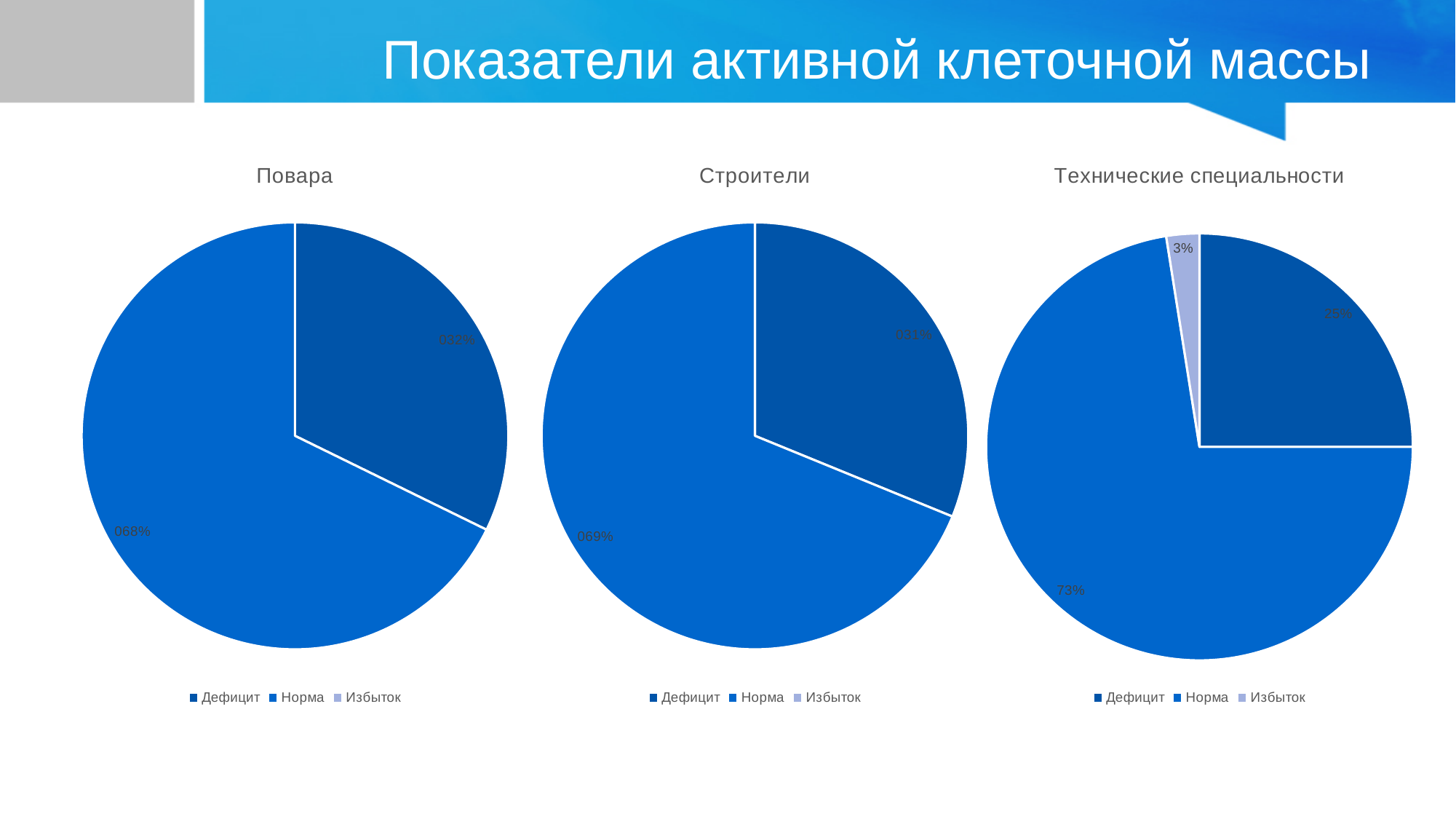
In the 'Повара' chart, what is the value for Норма? 068% In the 'Строители' chart, which category has the largest slice? Норма What kind of chart is the 'Повара' chart? pie chart In the 'Технические специальности' chart, what is the value for Норма? 73% In the 'Строители' chart, what is the value for Дефицит? 031% In the 'Повара' chart, what is the value for Дефицит? 032% How many pie charts are shown on the slide? 3 In the 'Технические специальности' chart, which category has the smallest slice? Избыток In the 'Технические специальности' chart, what is the value for Избыток? 3% In the 'Строители' chart, what is the value for Норма? 069% How many entries does the legend of the 'Повара' chart list? 3 In the 'Технические специальности' chart, what is the difference between Норма and Дефицит? 48%